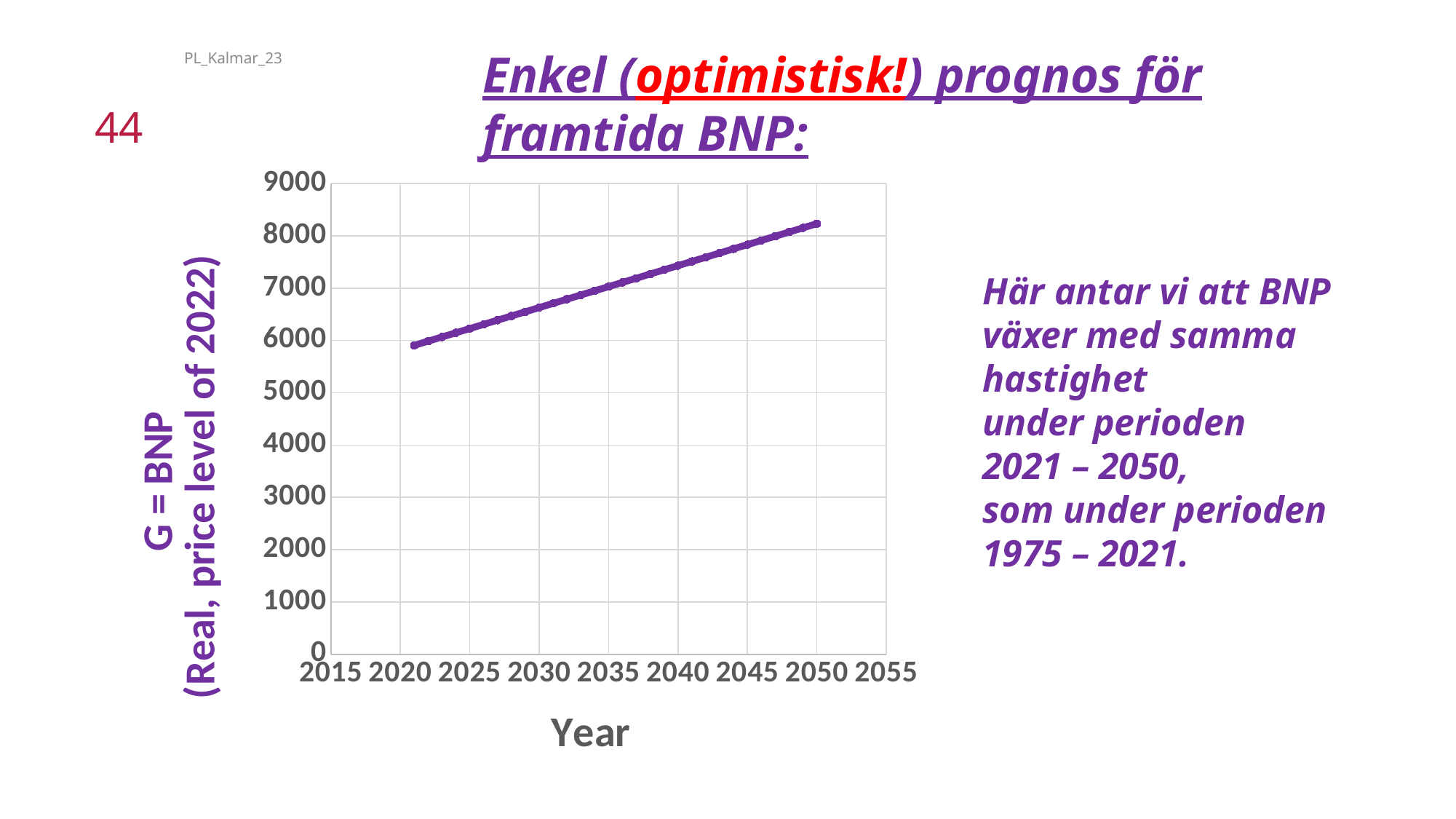
Is the BNP value for 2025 greater or less than 7000? less Is the BNP value for 2050 greater or less than 7000? greater What is the highest value shown on the y axis? 9000 Which year has the highest BNP value on the chart? 2050 Which is larger, the BNP value for 2050 or the BNP value for 2021? 2050 Do the BNP values rise or fall as the year increases from 2021 to 2050? rise What is the title of the x axis? Year Is the BNP value for 2021 greater or less than 5000? greater Which year has the lowest BNP value on the chart? 2021 What kind of chart is shown on the slide? line chart